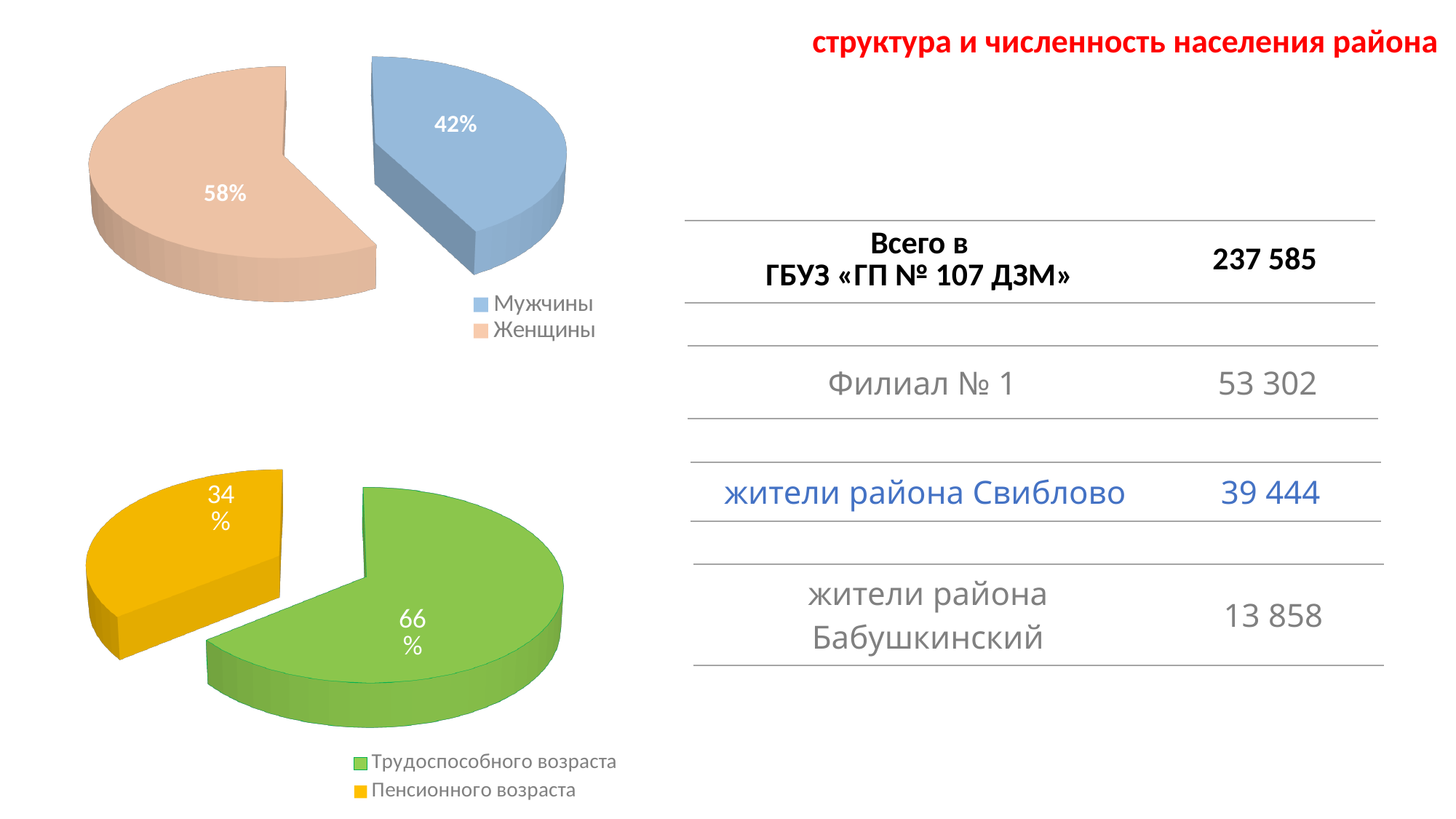
How many entries does the legend of the top-left pie chart list? 2 In the bottom-left pie chart, what share is labelled for Пенсионного возраста? 34% How many slices does the bottom-left pie chart have? 2 In the top-left pie chart, which slice is larger, Мужчины or Женщины? Женщины In the top-left pie chart, what is the difference in percentage points between the Женщины and Мужчины slices? 16 In the bottom-left pie chart, what is the difference in percentage points between the Трудоспособного возраста and Пенсионного возраста slices? 32 In the bottom-left pie chart, which slice is the largest? Трудоспособного возраста In the bottom-left pie chart, what share is labelled for Трудоспособного возраста? 66% In the top-left pie chart, what share is labelled for Мужчины? 42% In the bottom-left pie chart, what colour is the Пенсионного возраста slice? Yellow What type of chart is the top-left chart? Pie chart